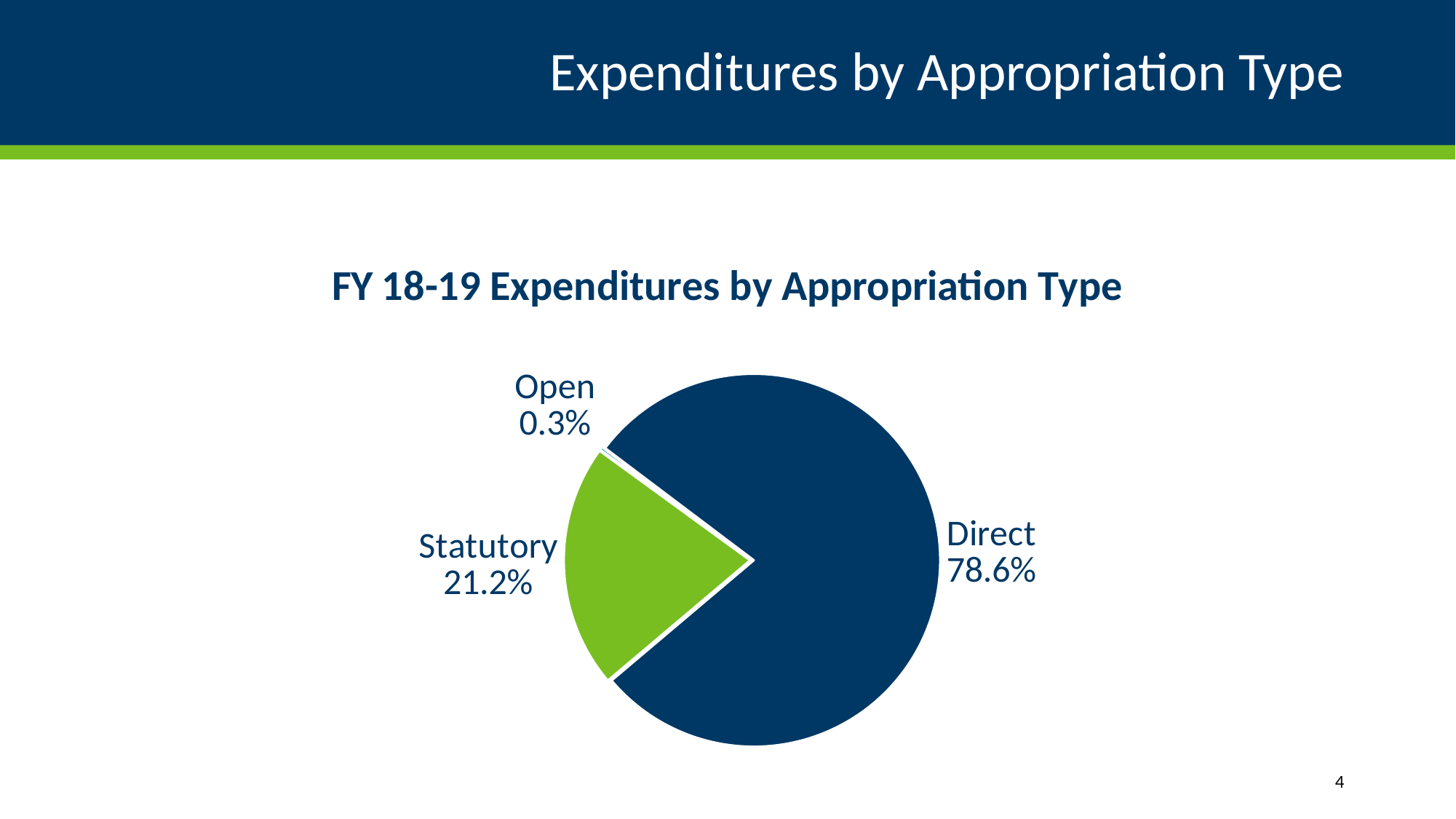
How many slices does the pie chart have? 3 What share of expenditures is Open? 0.3% What is the difference in percentage points between the Statutory and Open shares? 20.9 Which is larger, the Statutory share or the Open share? Statutory What share of expenditures is Statutory? 21.2% Which appropriation type has the smallest share? Open What is the title of the chart? FY 18-19 Expenditures by Appropriation Type What share of expenditures is Direct? 78.6% Which appropriation type has the largest share? Direct What kind of chart is shown on the slide? Pie chart What is the difference in percentage points between the Direct and Statutory shares? 57.4 What colour is the Statutory slice? Green